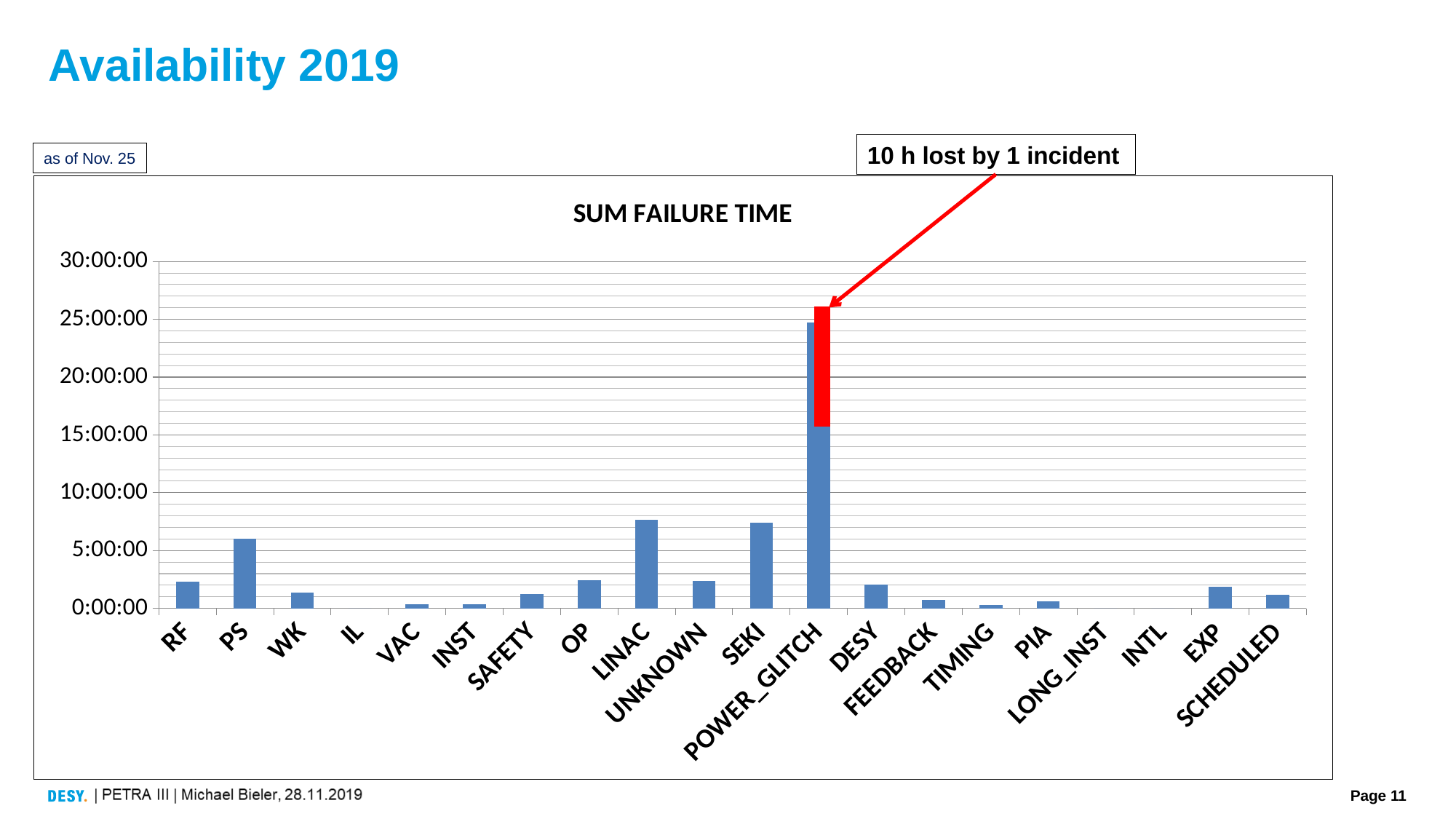
Is the value for POWER_GLITCH greater or less than 20:00:00? greater What kind of chart is shown on the slide? bar chart Is the value for SEKI greater or less than 10:00:00? less Which has a larger sum failure time, PS or WK? PS Is the value for LINAC greater or less than 5:00:00? greater Which has a larger sum failure time, LINAC or RF? LINAC Which has a larger sum failure time, UNKNOWN or SEKI? SEKI How many categories are shown on the x axis of the chart? 20 Which category has the highest sum failure time? POWER_GLITCH What is the title of the chart? SUM FAILURE TIME What is the highest tick value shown on the y axis? 30:00:00